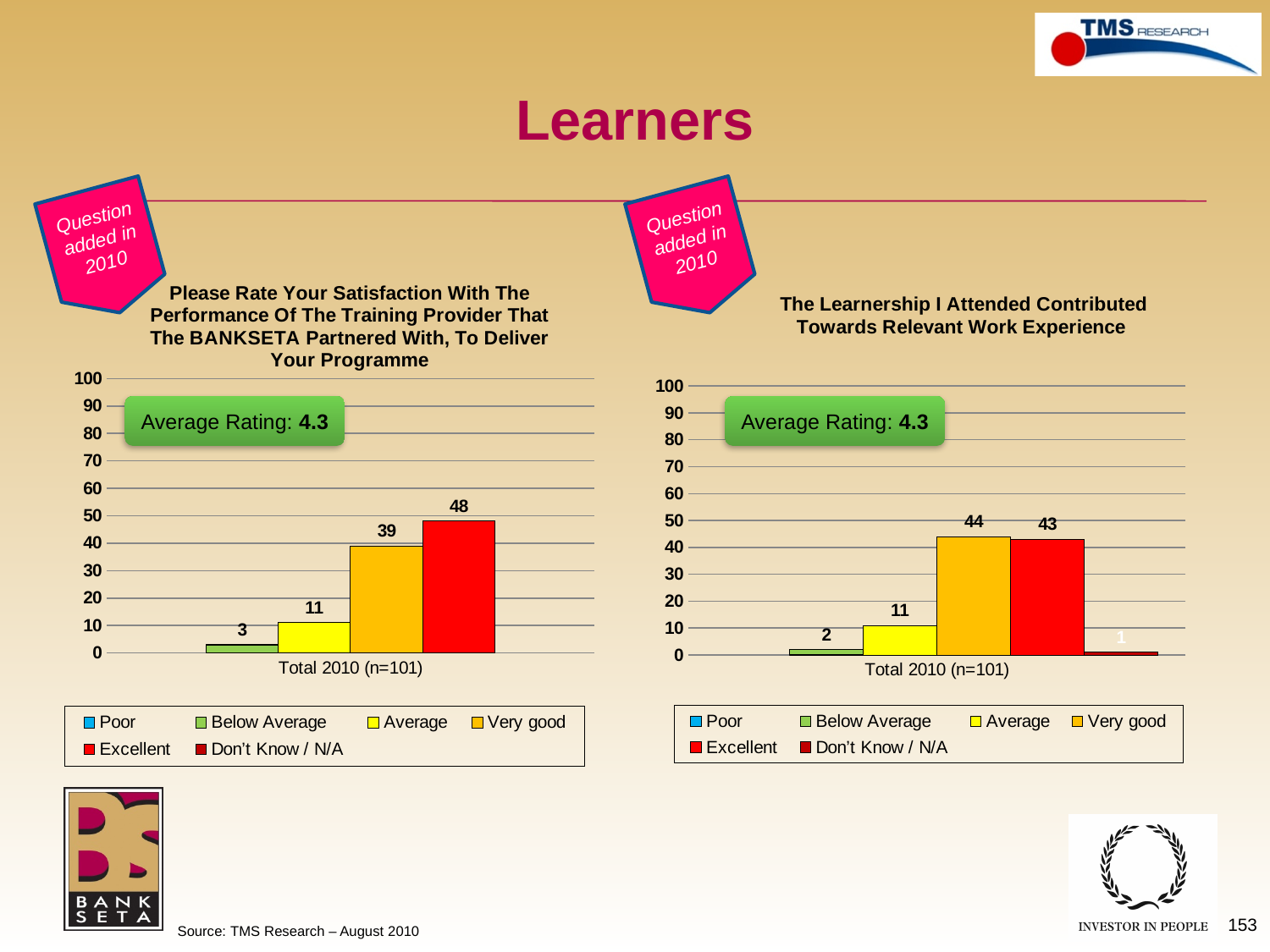
In the left chart (training provider satisfaction), what is the value for Very good? 39 In the left chart (training provider satisfaction), which rating category has the highest value? Excellent In the right chart (learnership contributed towards relevant work experience), what is the difference between the Very good and Excellent values? 1 In the right chart (learnership contributed towards relevant work experience), what is the value for Very good? 44 In the left chart (training provider satisfaction), what is the value for Below Average? 3 In the left chart (training provider satisfaction), what is the value for Excellent? 48 In the right chart (learnership contributed towards relevant work experience), what is the value for Don't Know / N/A? 1 What type of chart is the left chart? Bar chart In the right chart (learnership contributed towards relevant work experience), which is larger, Average or Below Average? Average What average rating is shown on the right chart? 4.3 How many series does the legend of the right chart list? 6 In the left chart (training provider satisfaction), what is the difference between the Excellent and Very good values? 9